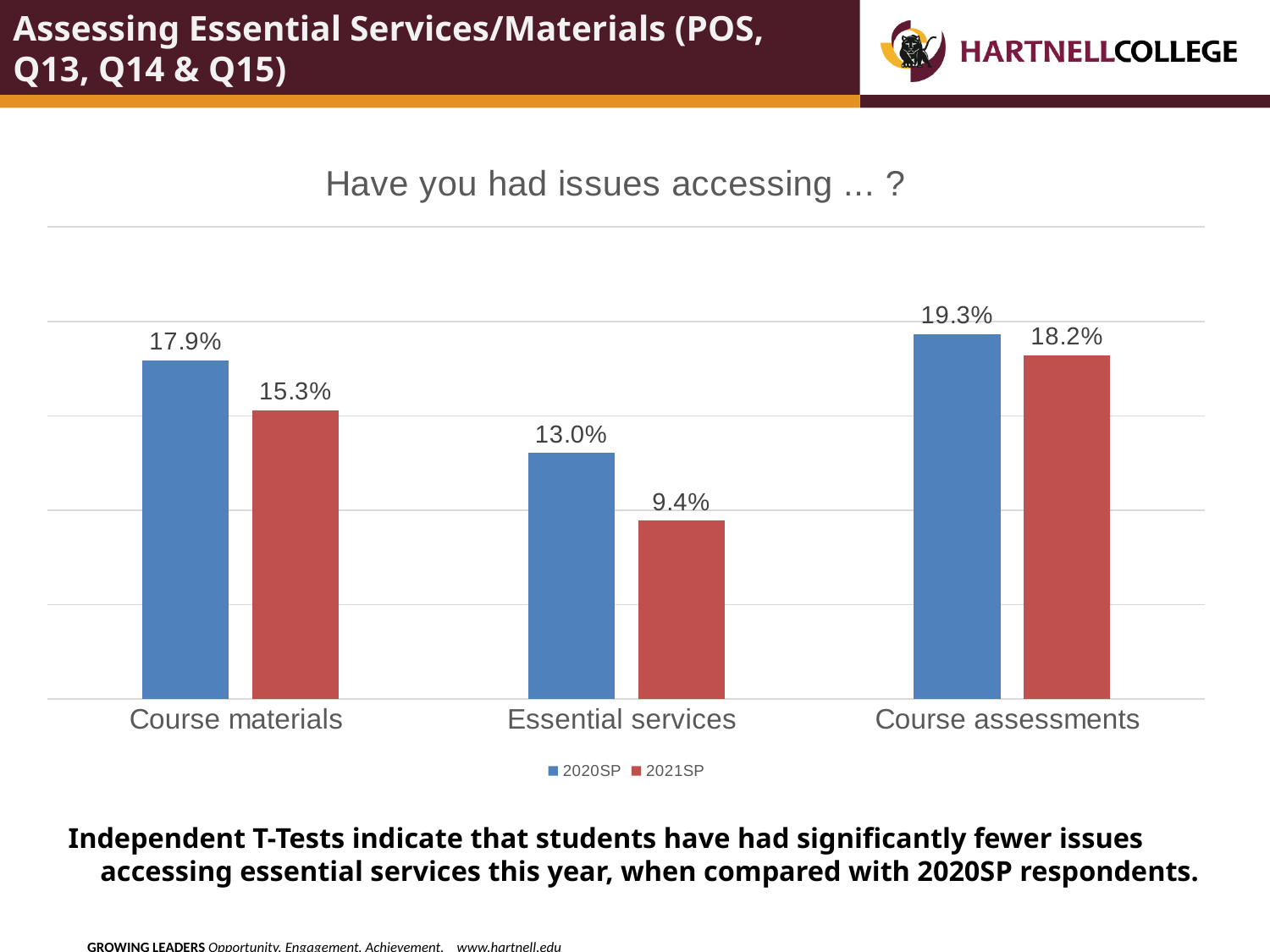
What is the difference between the 2020SP and 2021SP values for Course materials? 2.6% Which category has the lowest 2021SP value? Essential services Which is larger for Course materials, the 2020SP value or the 2021SP value? 2020SP What is the 2020SP value for Course materials? 17.9% How many categories are shown on the x axis? 3 What is the 2021SP value for Essential services? 9.4% How many series does the legend list? 2 What kind of chart is shown on the slide? Bar chart Which category has the highest 2020SP value? Course assessments What is the difference between the 2020SP and 2021SP values for Essential services? 3.6% What is the 2021SP value for Course assessments? 18.2% What is the title of the chart? Have you had issues accessing ... ?